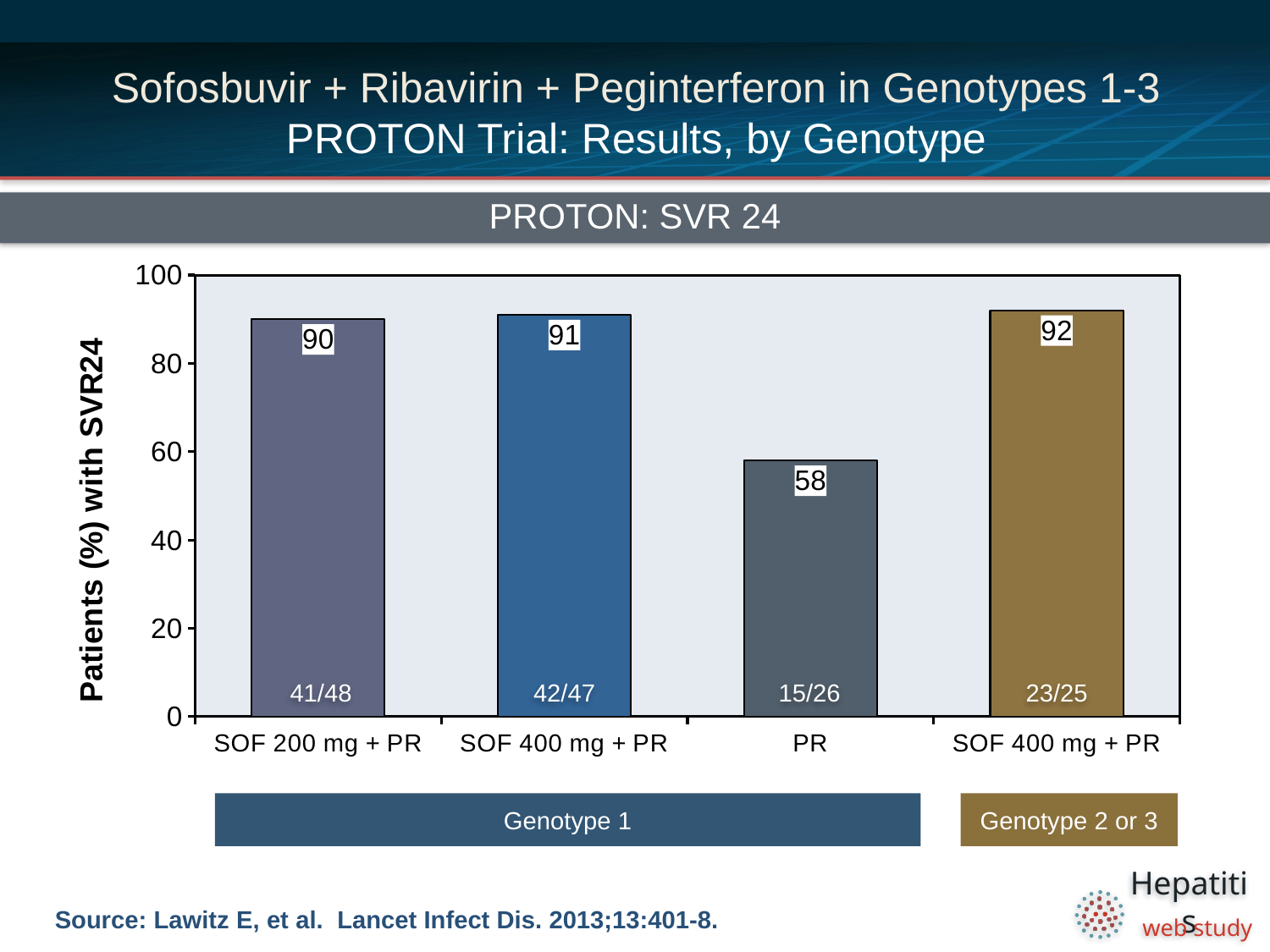
What fraction of patients is shown inside the PR bar? 15/26 Which arm has the highest SVR24 rate? SOF 400 mg + PR (Genotype 2 or 3) Which has a higher SVR24 rate, SOF 200 mg + PR or PR? SOF 200 mg + PR What is the SVR24 rate for the PR arm? 58 How many bars are shown in the chart? 4 What is the label of the y-axis? Patients (%) with SVR24 What is the SVR24 rate for SOF 400 mg + PR in Genotype 2 or 3? 92 What is the SVR24 rate for SOF 200 mg + PR in Genotype 1? 90 What type of chart is shown on the slide? Bar chart Which arm has the lowest SVR24 rate? PR What fraction of patients is shown inside the SOF 400 mg + PR bar for Genotype 1? 42/47 What is the difference in SVR24 rate between SOF 400 mg + PR in Genotype 1 and PR? 33